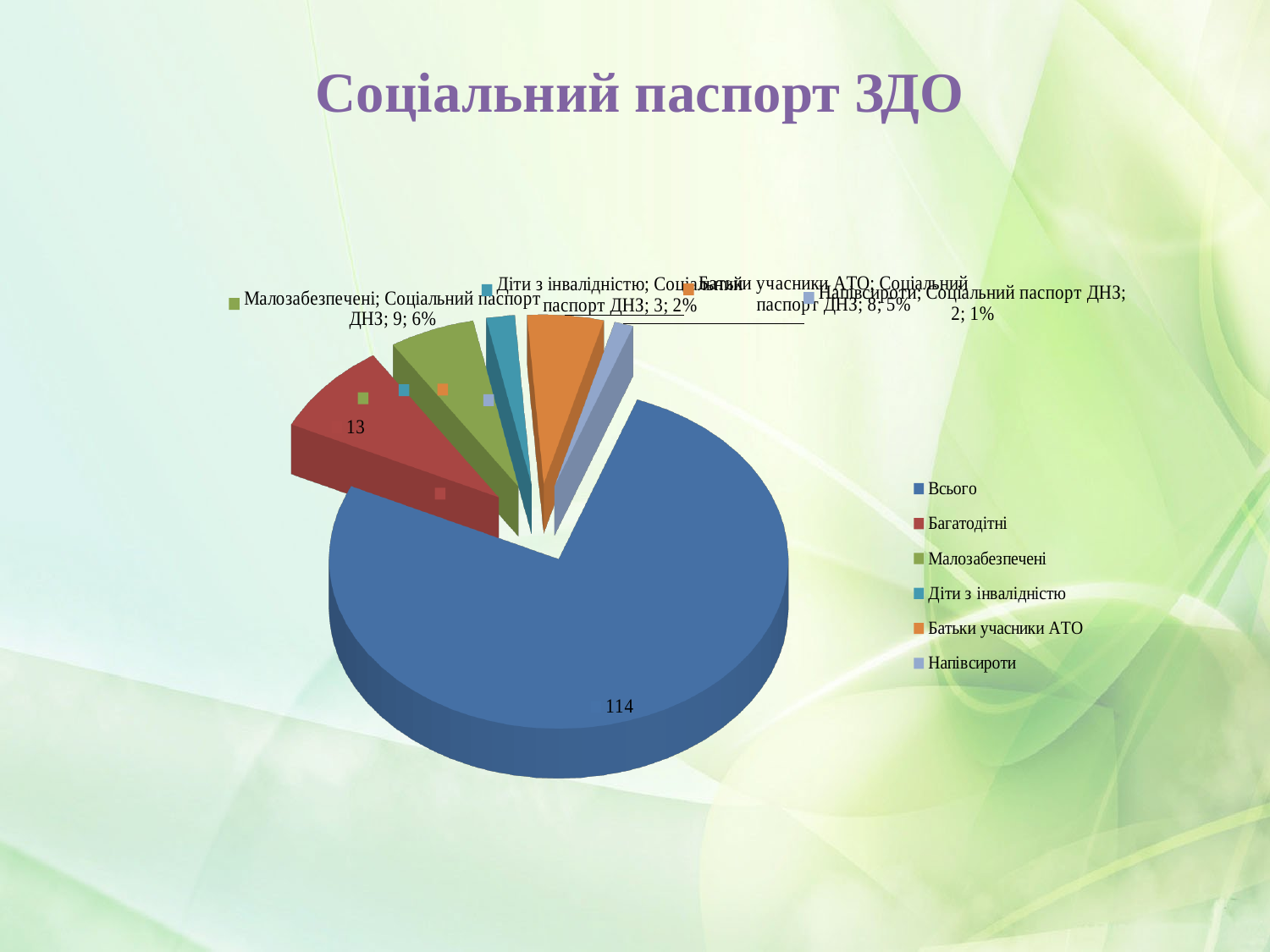
What percentage share is shown for Батьки учасники АТО? 5% What is the value shown for Діти з інвалідністю in the pie chart? 3 What is the value shown for Всього in the pie chart? 114 Which category has the smallest slice in the pie chart? Напівсироти How many entries does the legend of the pie chart list? 6 What is the value shown for Багатодітні in the pie chart? 13 Which is larger, the value for Батьки учасники АТО or the value for Діти з інвалідністю? Батьки учасники АТО What percentage share is shown for Напівсироти? 1% What kind of chart is shown on the slide? pie chart What is the difference between the values for Багатодітні and Малозабезпечені? 4 Which category has the largest slice in the pie chart? Всього What is the value shown for Малозабезпечені in the pie chart? 9